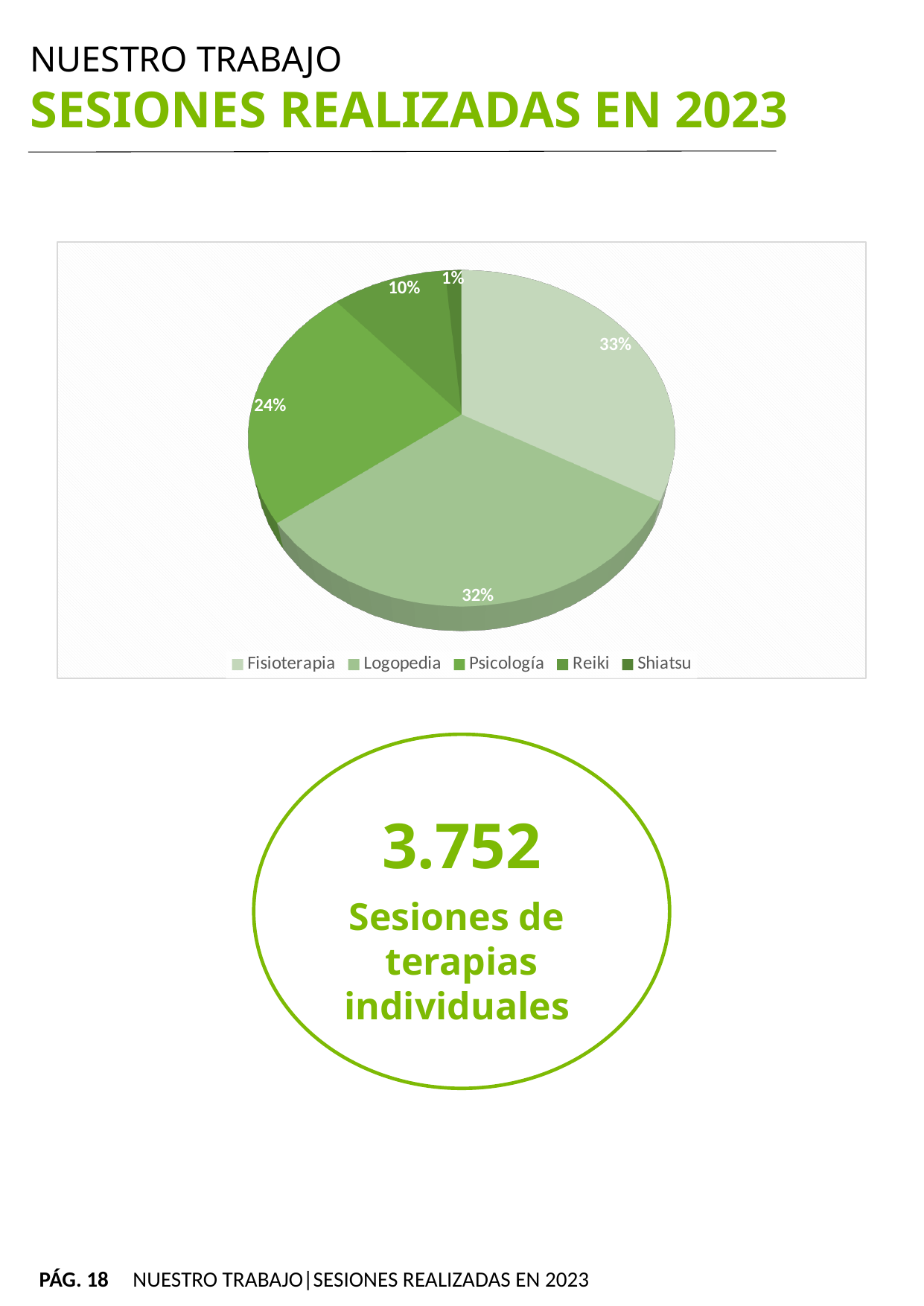
Which therapy has the smallest slice of the pie? Shiatsu What share of the pie does Reiki represent? 10% What kind of chart is shown on the slide? Pie chart How many categories does the pie chart show? 5 Which slice is larger, Psicología or Reiki? Psicología What share of the pie does Psicología represent? 24% Which therapy has the largest slice of the pie? Fisioterapia What is the difference in percentage points between the Psicología and Reiki slices? 14% What share of the pie does Fisioterapia represent? 33% What is the total number of individual therapy sessions stated on the slide? 3.752 What share of the pie does Shiatsu represent? 1% What share of the pie does Logopedia represent? 32%